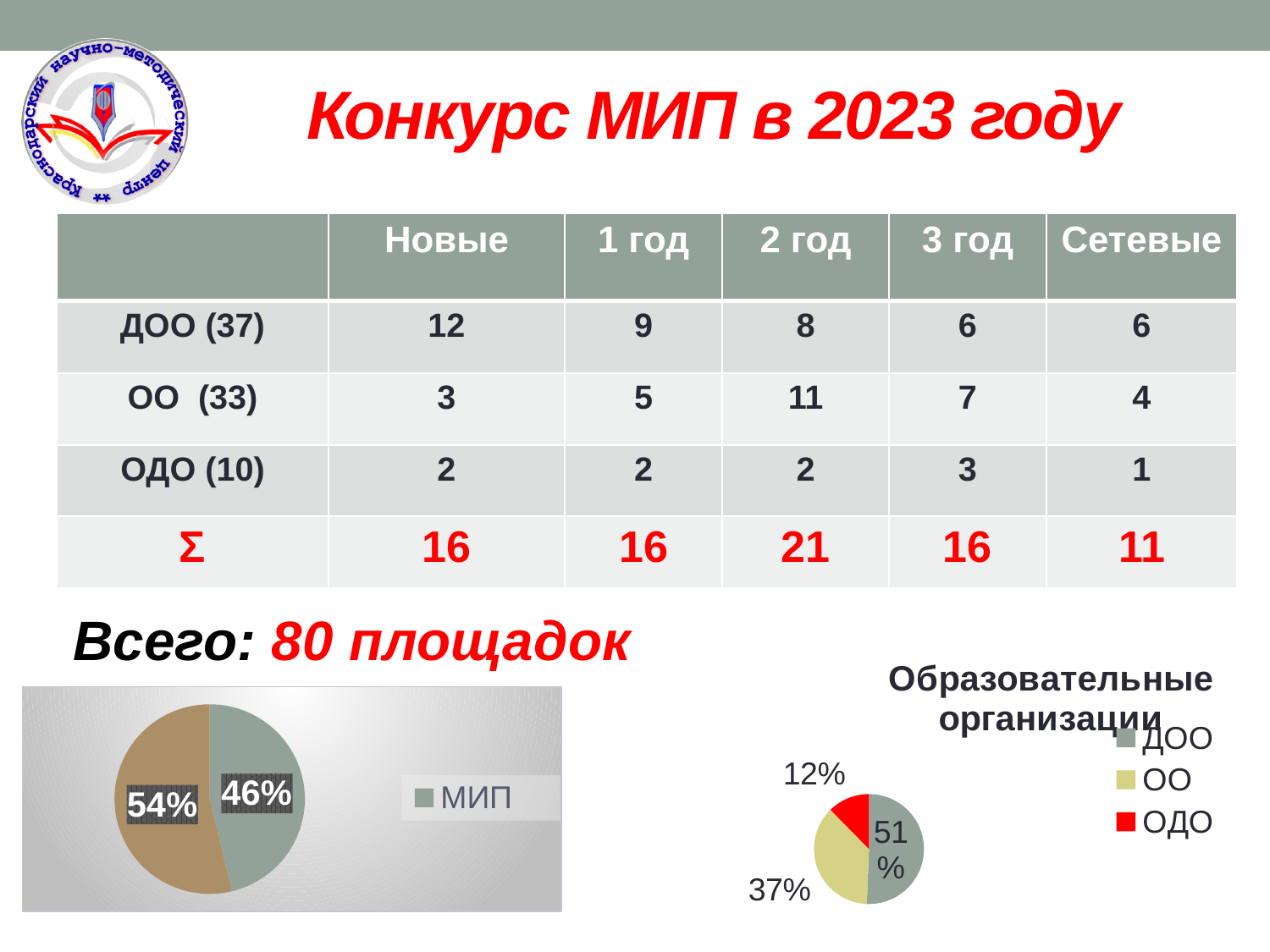
In the pie chart titled 'Образовательные организации', what colour is the ОДО slice? Red In the pie chart titled 'Образовательные организации', which category has the smallest slice? ОДО In the pie chart at the bottom left of the slide, what share is labelled on the slice matching the legend entry МИП? 46% In the pie chart titled 'Образовательные организации', what share does ДОО have? 51% In the pie chart at the bottom left of the slide, what is the only entry shown in the legend? МИП In the pie chart titled 'Образовательные организации', which slice is larger, ОО or ОДО? ОО In the pie chart titled 'Образовательные организации', how many categories does the legend list? 3 What kind of chart is shown at the bottom left of the slide? Pie chart In the pie chart titled 'Образовательные организации', what share does ОДО have? 12% In the pie chart titled 'Образовательные организации', which category has the largest slice? ДОО In the pie chart titled 'Образовательные организации', how many percentage points larger is the ДОО slice than the ОО slice? 14